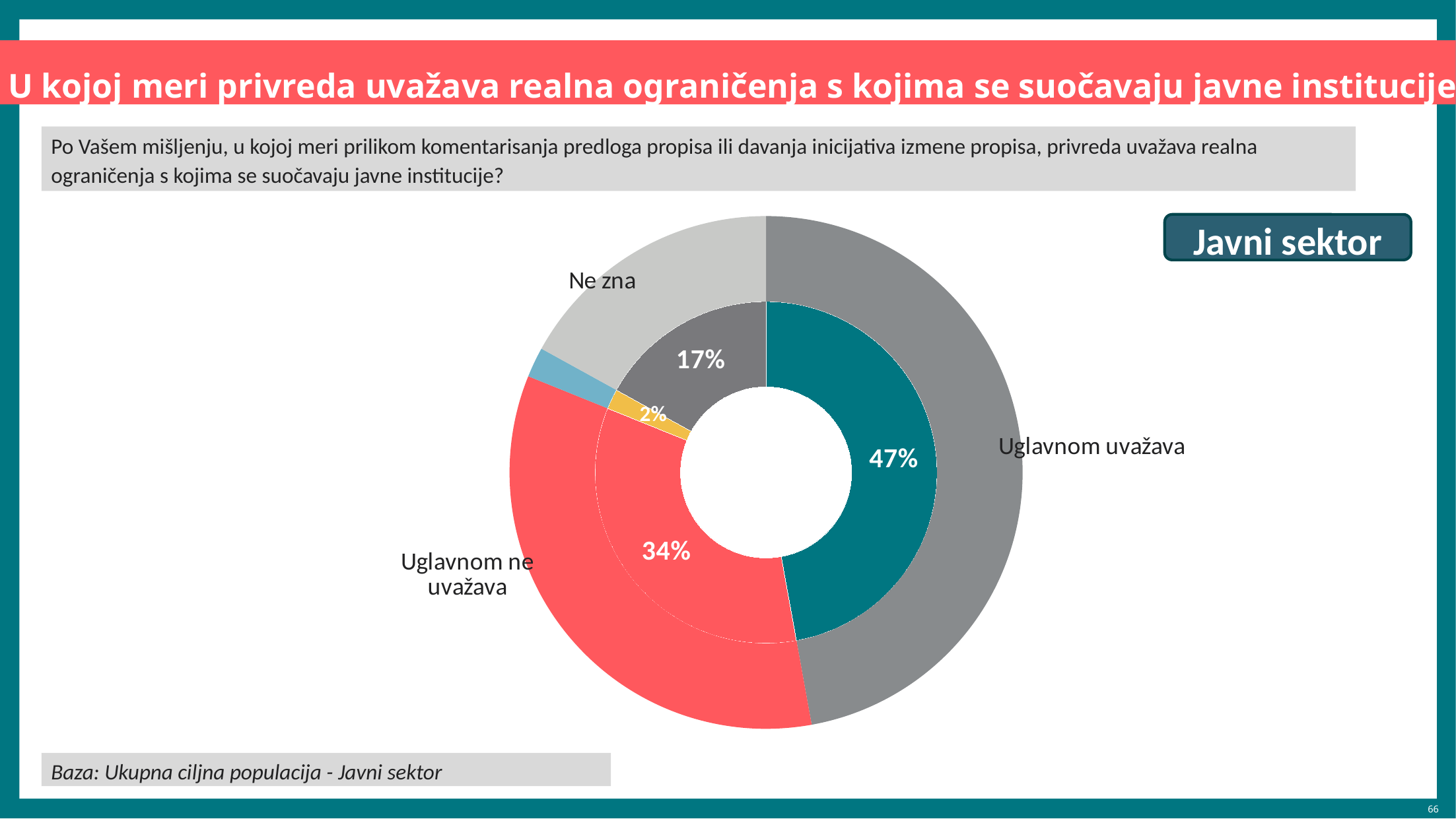
What percentage is shown for "Uglavnom ne uvažava"? 34% What is the difference in percentage points between "Uglavnom uvažava" and "Uglavnom ne uvažava"? 13 percentage points How many segments does the chart have? 4 What percentage is shown for "Uglavnom uvažava"? 47% What colour is the segment labelled "Uglavnom ne uvažava"? Red Which is larger, the share for "Uglavnom ne uvažava" or the share for "Ne zna"? Uglavnom ne uvažava Which labelled category has the largest share in the chart? Uglavnom uvažava What type of chart is shown on the slide? Doughnut (pie) chart What is the difference in percentage points between "Uglavnom ne uvažava" and "Ne zna"? 17 percentage points Which sector does the label in the top-right box say the chart refers to? Javni sektor What is the smallest percentage value printed on the chart? 2% What percentage is shown for "Ne zna"? 17%